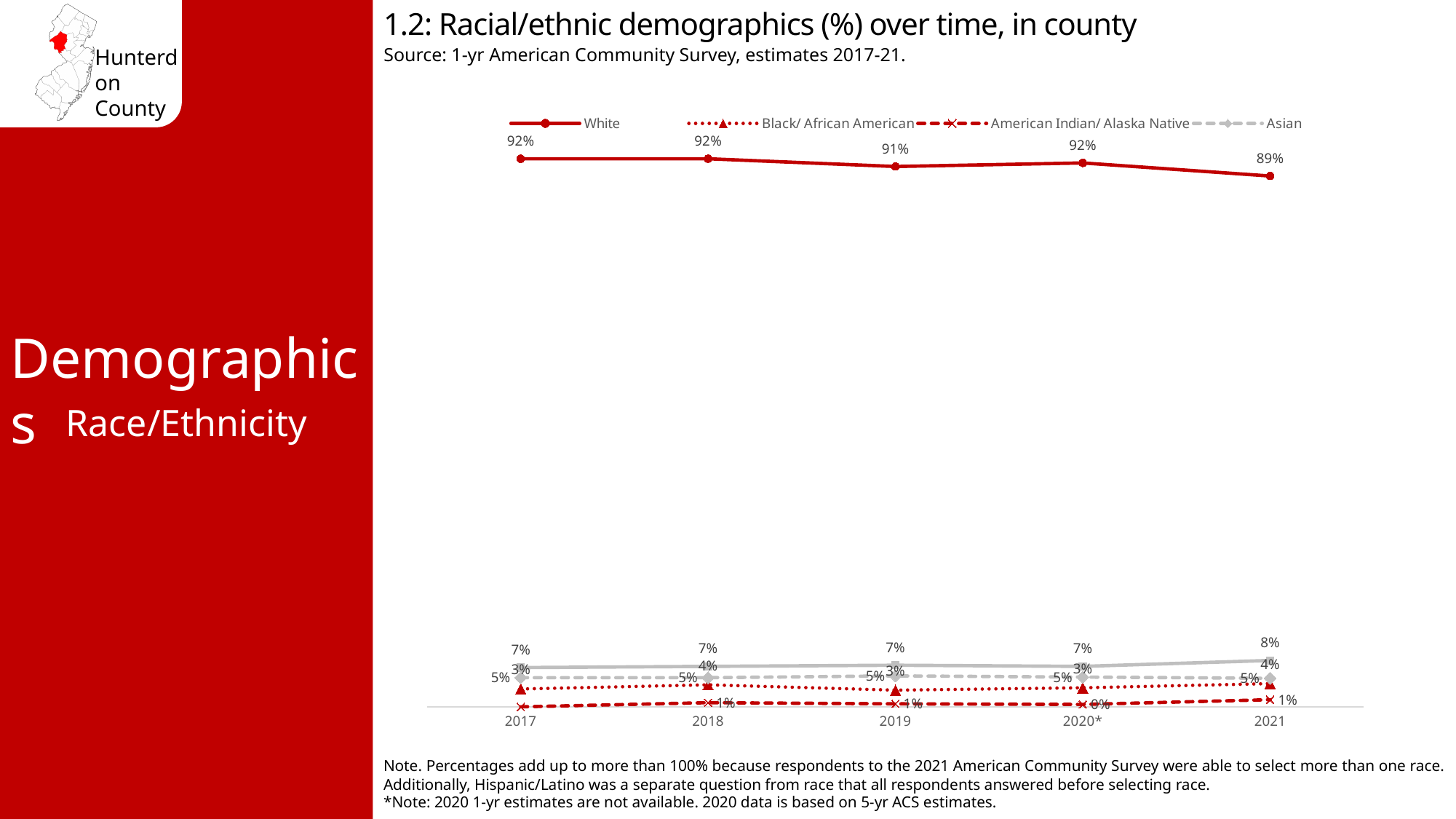
What is the value for White in 2021? 89% What is the value for Black/ African American in 2018? 4% Which is larger, the White value in 2019 or in 2020*? 2020* Does the White series rise or fall overall from 2017 to 2021? Fall What is the difference between the White value in 2017 and in 2021? 3 percentage points How many years are shown on the x axis? 5 How many series does the legend list? 4 What kind of chart is shown? Line chart What is the value for Asian in 2017? 5% What is the value for American Indian/ Alaska Native in 2020*? 0% What is the value for White in 2019? 91% In which year is the White value lowest? 2021